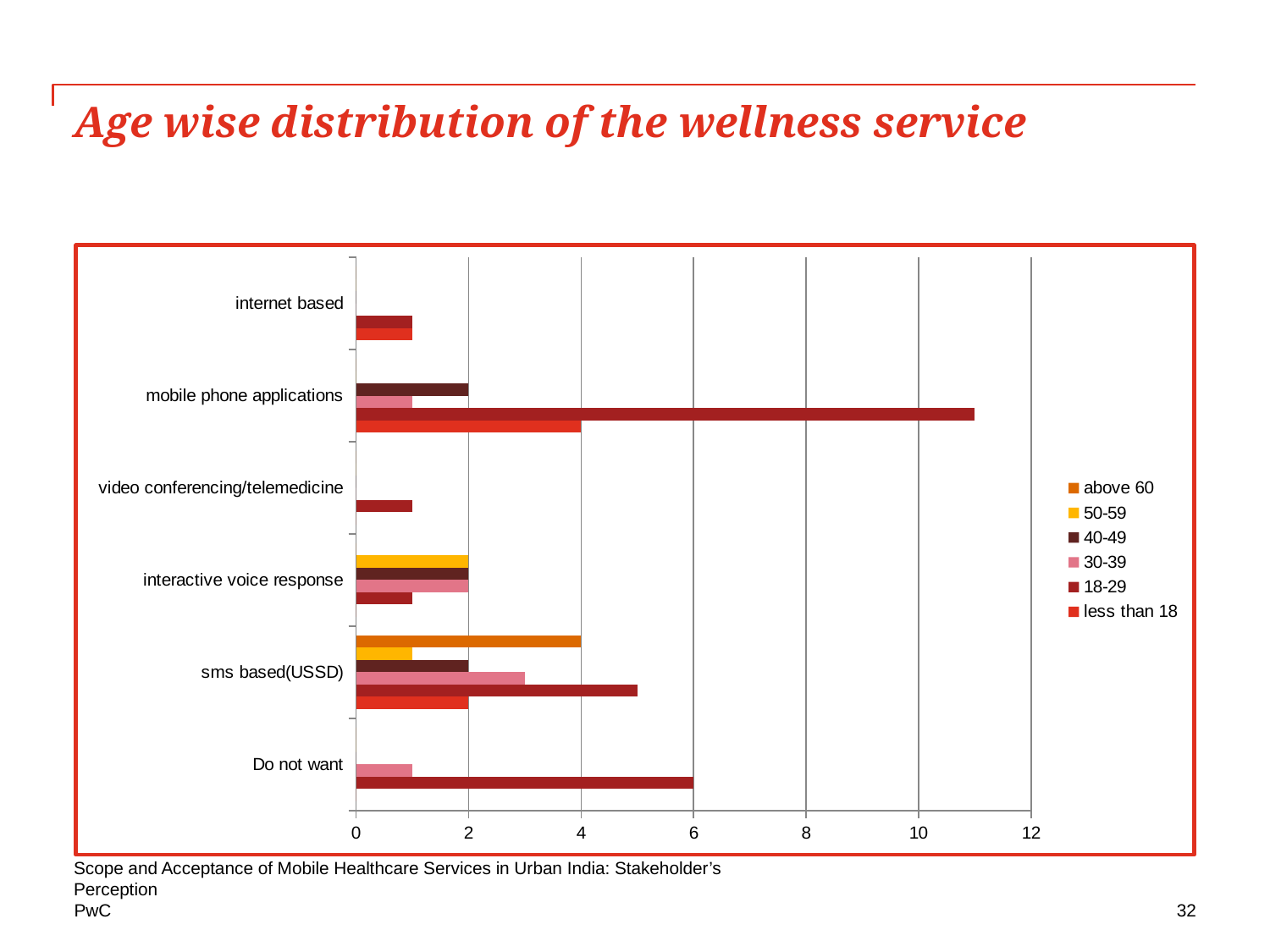
What is the value for the 'less than 18' series in the 'mobile phone applications' category? 4 In the 'sms based(USSD)' category, which is larger: the '18-29' value or the '30-39' value? 18-29 What is the value for the 'above 60' series in the 'sms based(USSD)' category? 4 What is the difference between the 'above 60' value and the '40-49' value in the 'sms based(USSD)' category? 2 How many series does the legend list? 6 Which category has the highest value for the '18-29' series? mobile phone applications What is the value for the '18-29' series in the 'Do not want' category? 6 What kind of chart is shown on the slide? bar chart How many categories are shown on the vertical axis of the chart? 6 What is the title of the slide containing the chart? Age wise distribution of the wellness service Is the value for the '18-29' series in 'mobile phone applications' greater or less than 10? greater Is the value for the '30-39' series in 'Do not want' greater or less than 2? less